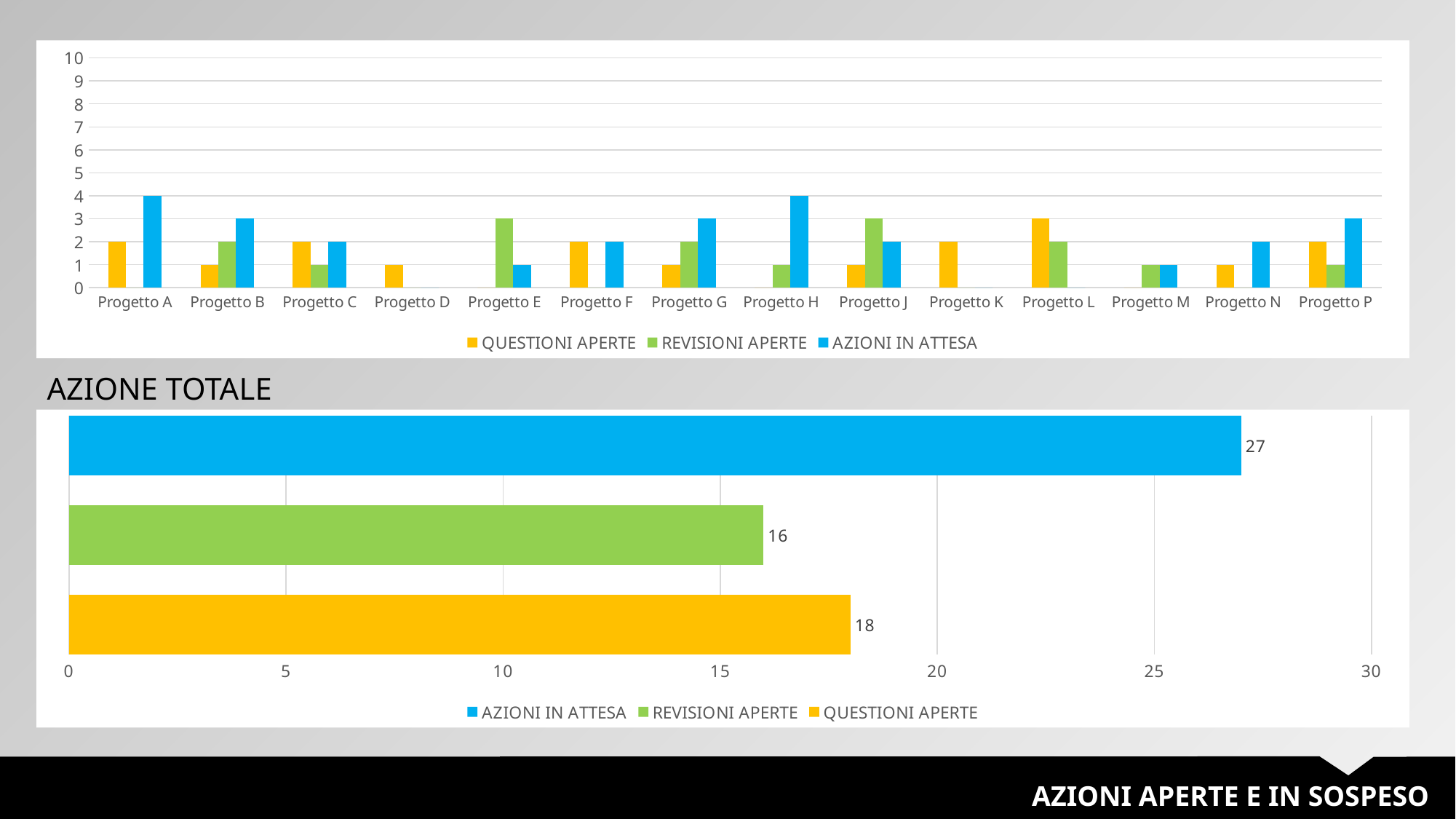
In the AZIONE TOTALE chart, which category has the highest value? AZIONI IN ATTESA In the AZIONE TOTALE chart, what type of chart is shown? Bar chart In the AZIONE TOTALE chart, what is the difference between AZIONI IN ATTESA and QUESTIONI APERTE? 9 In the top chart, how many projects are shown on the x axis? 14 In the top chart, what is the value of AZIONI IN ATTESA for Progetto A? 4 In the AZIONE TOTALE chart, what is the value for REVISIONI APERTE? 16 In the top chart, how many series does the legend list? 3 In the AZIONE TOTALE chart, which category has the lowest value? REVISIONI APERTE In the AZIONE TOTALE chart, what is the value for QUESTIONI APERTE? 18 In the AZIONE TOTALE chart, what is the value for AZIONI IN ATTESA? 27 In the top chart, which is larger for Progetto E: REVISIONI APERTE or AZIONI IN ATTESA? REVISIONI APERTE In the top chart, what is the value of QUESTIONI APERTE for Progetto L? 3